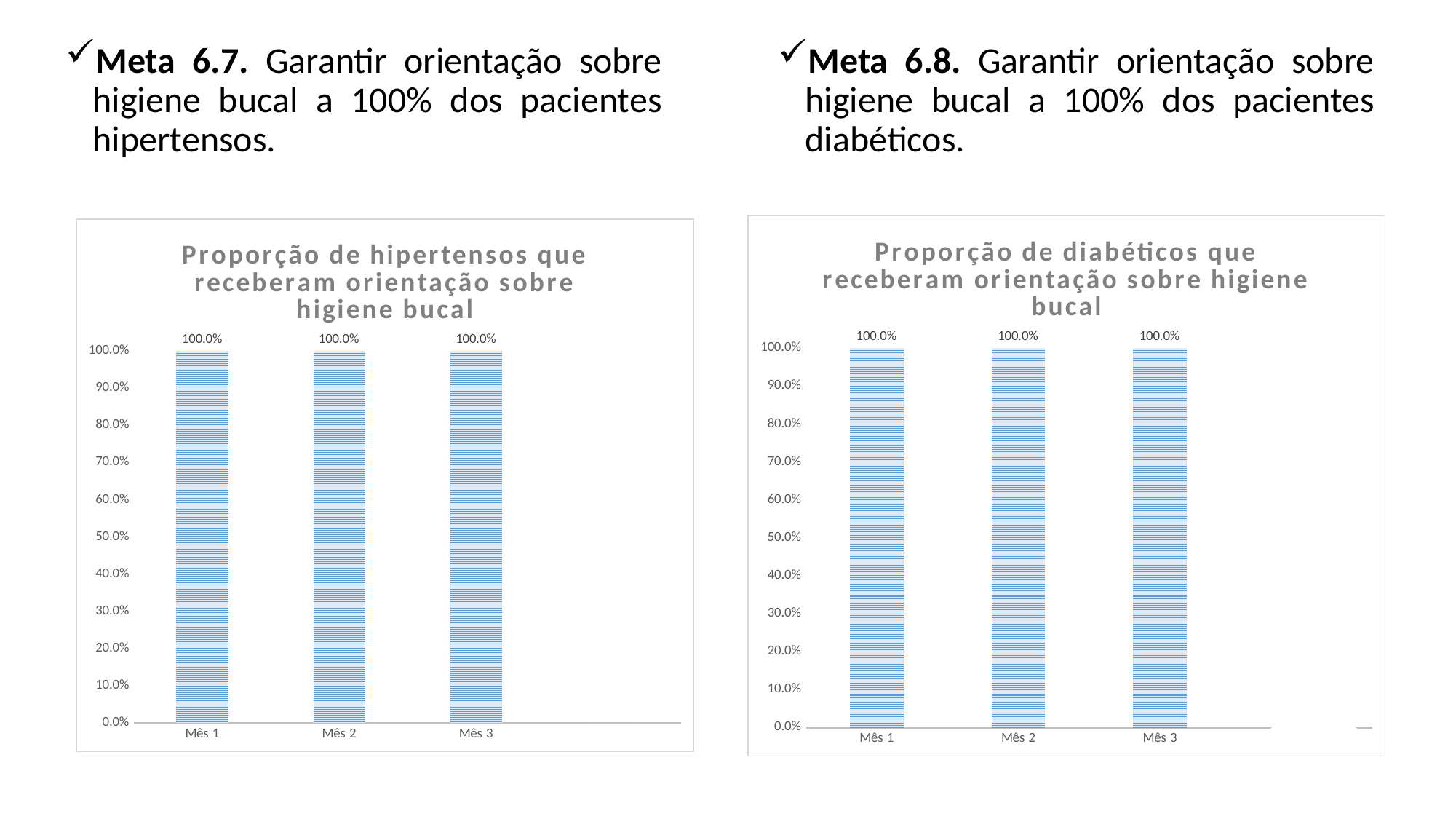
In the right chart (Proporção de diabéticos que receberam orientação sobre higiene bucal), what is the value for Mês 3? 100.0% In the left chart (Proporção de hipertensos que receberam orientação sobre higiene bucal), what is the difference between the values for Mês 1 and Mês 2? 0.0% How many categories are shown on the x axis of the left chart (Proporção de hipertensos que receberam orientação sobre higiene bucal)? 3 What kind of chart is the left chart (Proporção de hipertensos que receberam orientação sobre higiene bucal)? Bar chart What is the title of the right chart on the slide? Proporção de diabéticos que receberam orientação sobre higiene bucal Do the values in the right chart (Proporção de diabéticos que receberam orientação sobre higiene bucal) rise, fall, or stay the same from Mês 1 to Mês 3? Stay the same What is the highest value shown on the y axis of the left chart (Proporção de hipertensos que receberam orientação sobre higiene bucal)? 100.0% In the right chart (Proporção de diabéticos que receberam orientação sobre higiene bucal), what is the difference between the values for Mês 1 and Mês 3? 0.0% In the left chart (Proporção de hipertensos que receberam orientação sobre higiene bucal), what is the value for Mês 3? 100.0% How many bars are plotted in the right chart (Proporção de diabéticos que receberam orientação sobre higiene bucal)? 3 In the left chart (Proporção de hipertensos que receberam orientação sobre higiene bucal), what is the value for Mês 1? 100.0% In the right chart (Proporção de diabéticos que receberam orientação sobre higiene bucal), what is the value for Mês 2? 100.0%